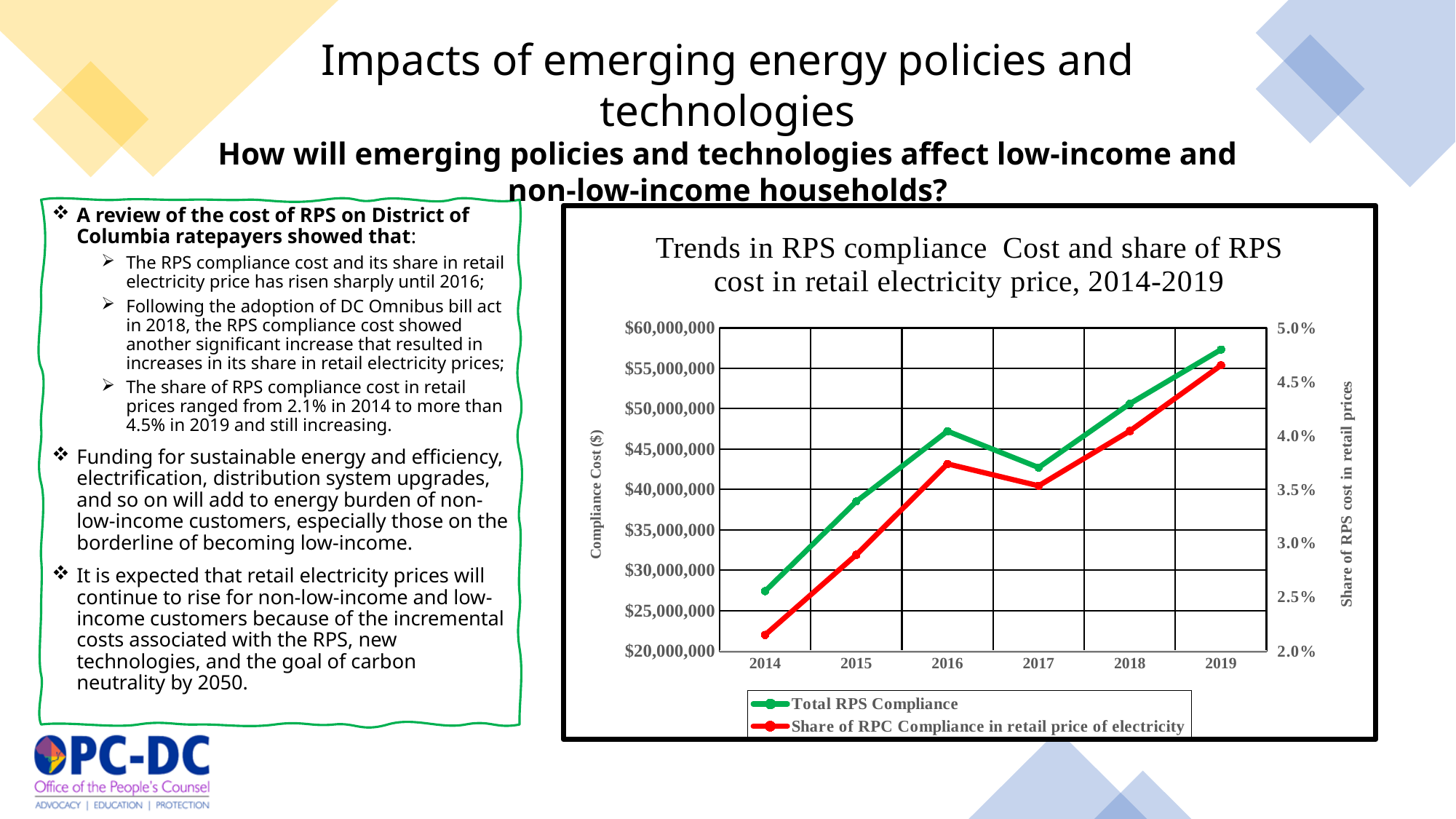
Which series is drawn in red on the chart? Share of RPC Compliance in retail price of electricity How many series does the chart legend list? 2 Between 2016 and 2017, does Total RPS Compliance rise or fall? fall Is the Share of RPC Compliance in retail price of electricity for 2019 greater or less than 4.5%? greater Which year has a higher Total RPS Compliance, 2016 or 2017? 2016 What kind of chart is shown on the slide? line chart Is the Total RPS Compliance value for 2014 greater or less than $30,000,000? less In which year is the Share of RPC Compliance in retail price of electricity lowest? 2014 How many years are plotted along the x axis of the chart? 6 In which year is Total RPS Compliance highest? 2019 Is the Total RPS Compliance value for 2016 greater or less than $45,000,000? greater In which year is Total RPS Compliance lowest? 2014